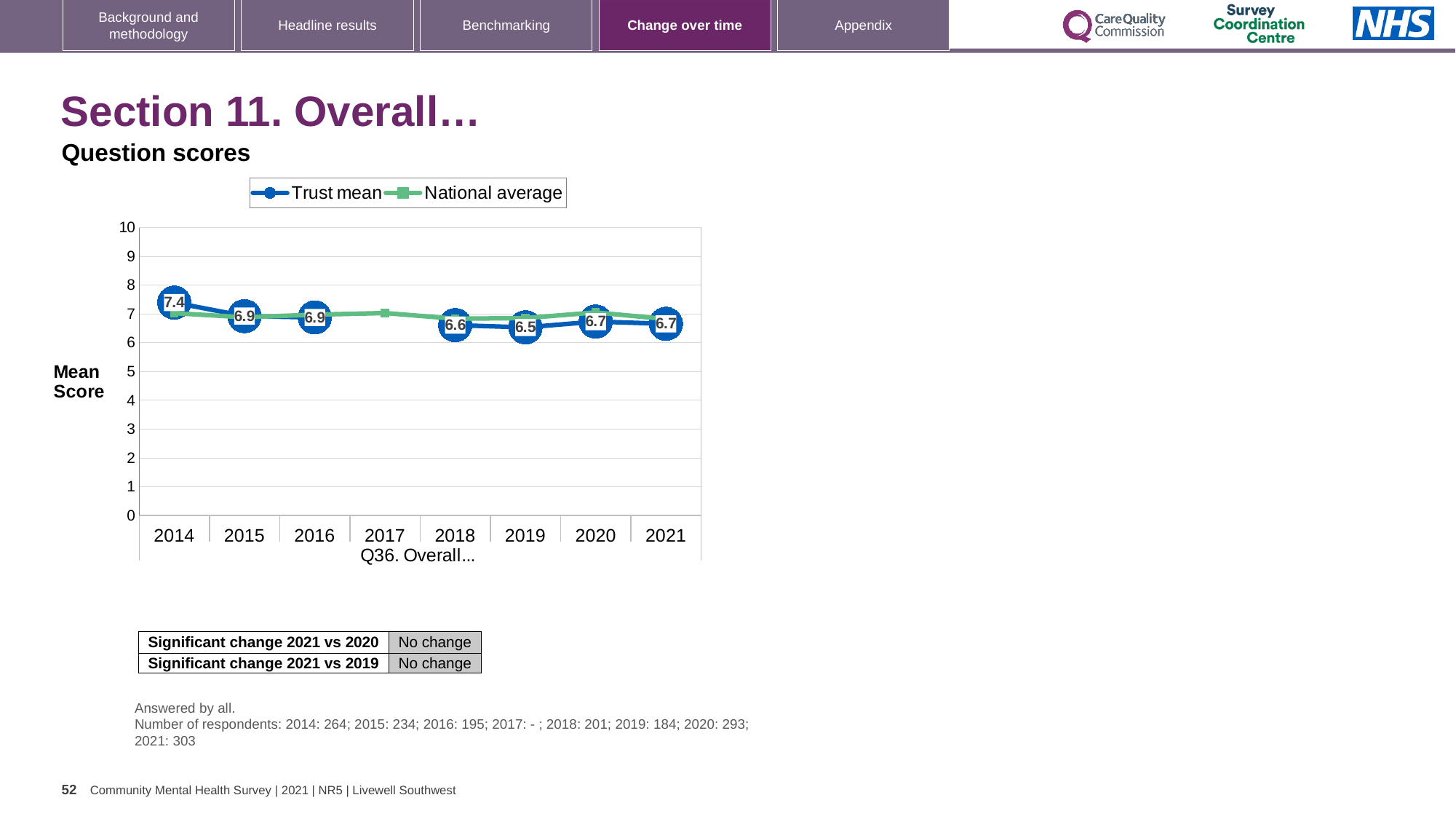
Is the National average value for 2017 greater or less than 5? greater What is the difference between the Trust mean score in 2014 and in 2019? 0.9 What is the Trust mean score for 2014? 7.4 How many series does the chart legend list? 2 What kind of chart is shown on the slide? Line chart In which year is the Trust mean score lowest? 2019 Does the Trust mean score rise or fall from 2014 to 2019? Fall What is the Trust mean score for 2019? 6.5 How many years are shown on the x axis of the chart? 8 What is the Trust mean score for 2021? 6.7 In which year is the Trust mean score highest? 2014 Which year has a higher Trust mean score, 2014 or 2021? 2014